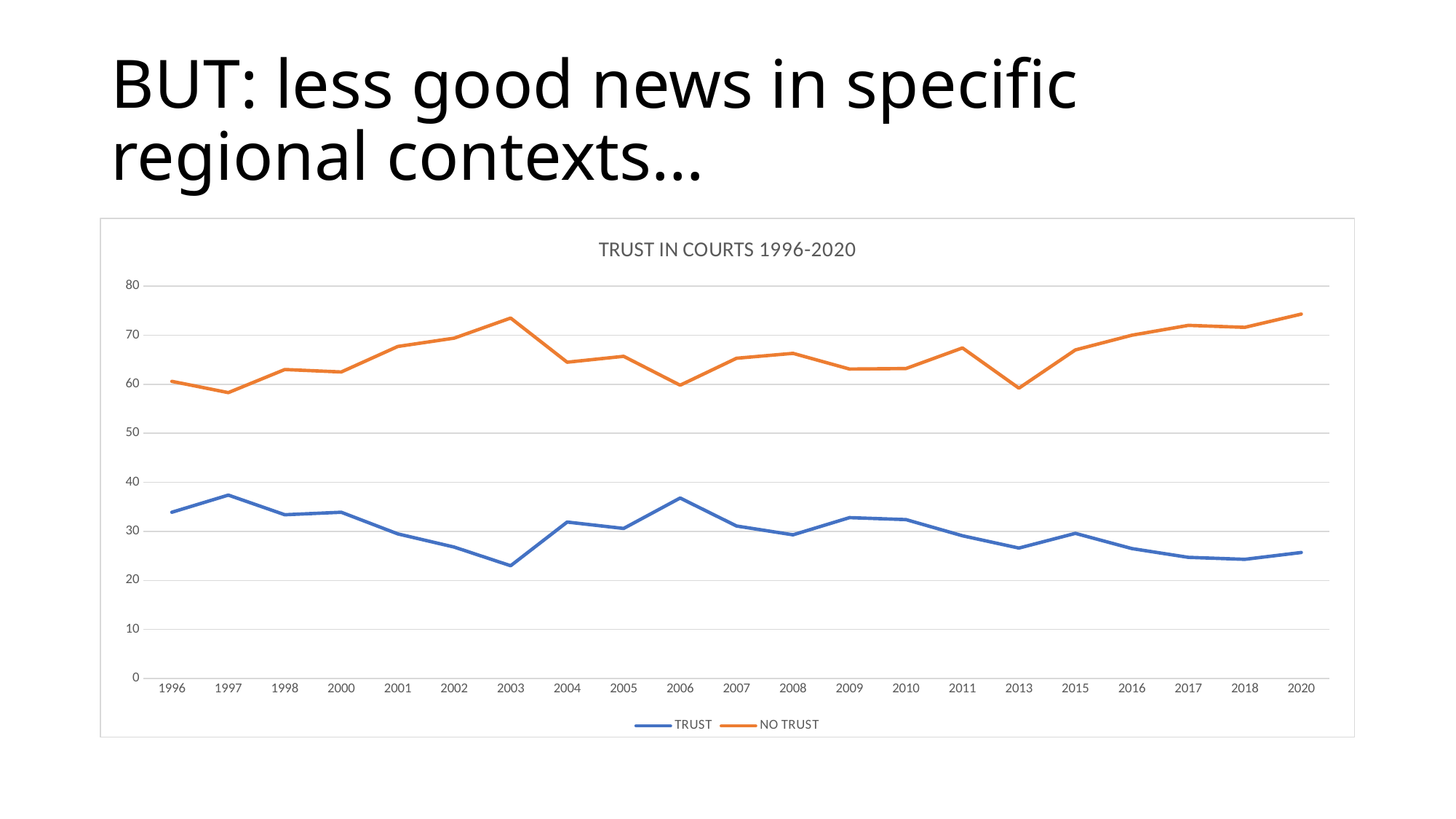
Which is larger, the NO TRUST value for 2003 or for 2004? 2003 Which series is drawn in orange? NO TRUST What kind of chart is shown on the slide? line chart Is the NO TRUST value for 2003 greater or less than 70? greater Is the TRUST value for 1997 greater or less than 30? greater Is the TRUST value for 2003 greater or less than 30? less How many years are shown on the x axis? 21 How many series does the legend list? 2 Does the NO TRUST line rise or fall from 2013 to 2020? rise Which is larger, the TRUST value for 1996 or for 2020? 1996 What is the title of the chart? TRUST IN COURTS 1996-2020